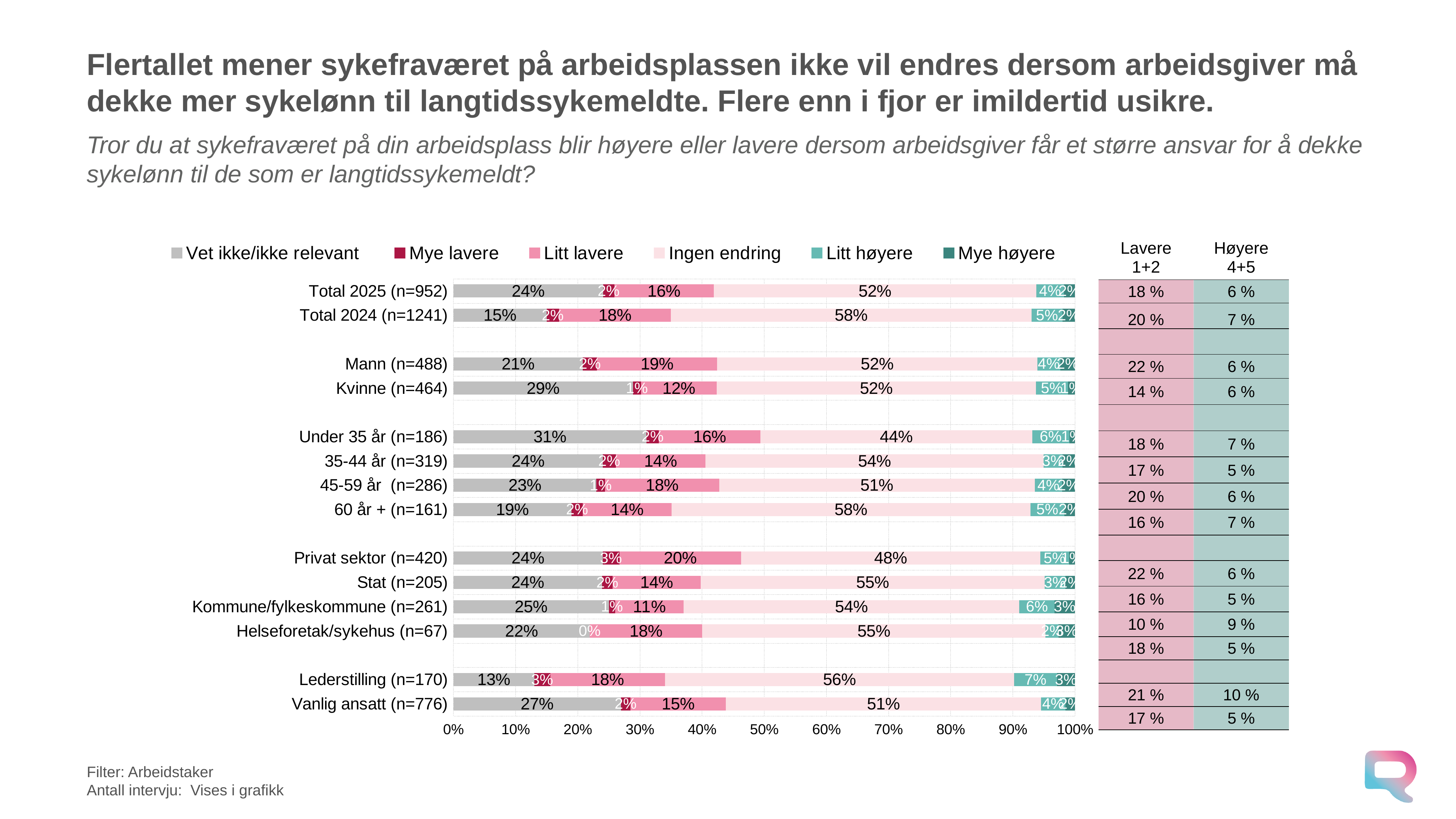
What kind of chart is shown on the slide? Stacked bar chart What is the 'Ingen endring' value for Total 2025 (n=952)? 52% How many categories (bars) are plotted in the chart? 14 Which category has the highest 'Vet ikke/ikke relevant' value? Under 35 år (n=186) What is the difference in 'Vet ikke/ikke relevant' between Total 2025 (n=952) and Total 2024 (n=1241)? 9 percentage points What is the 'Ingen endring' value for Total 2024 (n=1241)? 58% Which has the larger 'Litt lavere' value, Mann (n=488) or Kvinne (n=464)? Mann (n=488) What is the 'Vet ikke/ikke relevant' value for Kvinne (n=464)? 29% What is the 'Litt høyere' value for Lederstilling (n=170)? 7% What is the 'Litt lavere' value for Privat sektor (n=420)? 20% Which category has the lowest 'Vet ikke/ikke relevant' value? Lederstilling (n=170) How many series does the chart legend list? 6